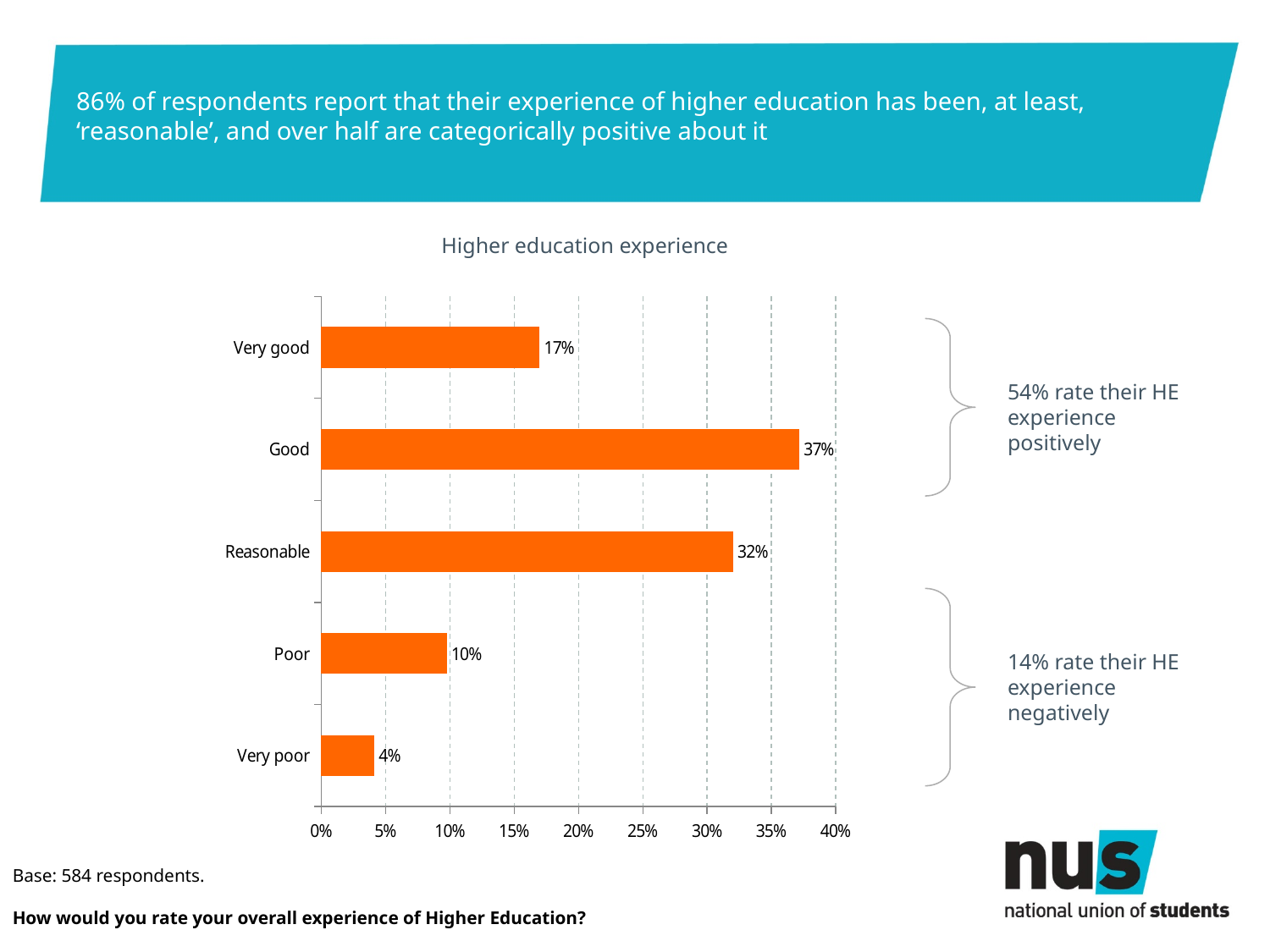
What is the value shown for 'Reasonable'? 32% What type of chart is shown on the slide? Bar chart How many categories are shown in the chart? 5 What percentage of respondents rated their higher education experience as 'Good'? 37% What is the difference between the 'Very good' and 'Poor' values? 7% Is the value for 'Good' greater or less than 35%? greater Which is larger, the value for 'Very good' or the value for 'Reasonable'? Reasonable What is the title of the chart? Higher education experience What percentage of respondents rated their higher education experience as 'Very poor'? 4% Which category has the lowest value in the chart? Very poor What is the difference between the 'Good' and 'Reasonable' values? 5% Which category has the highest value in the chart? Good